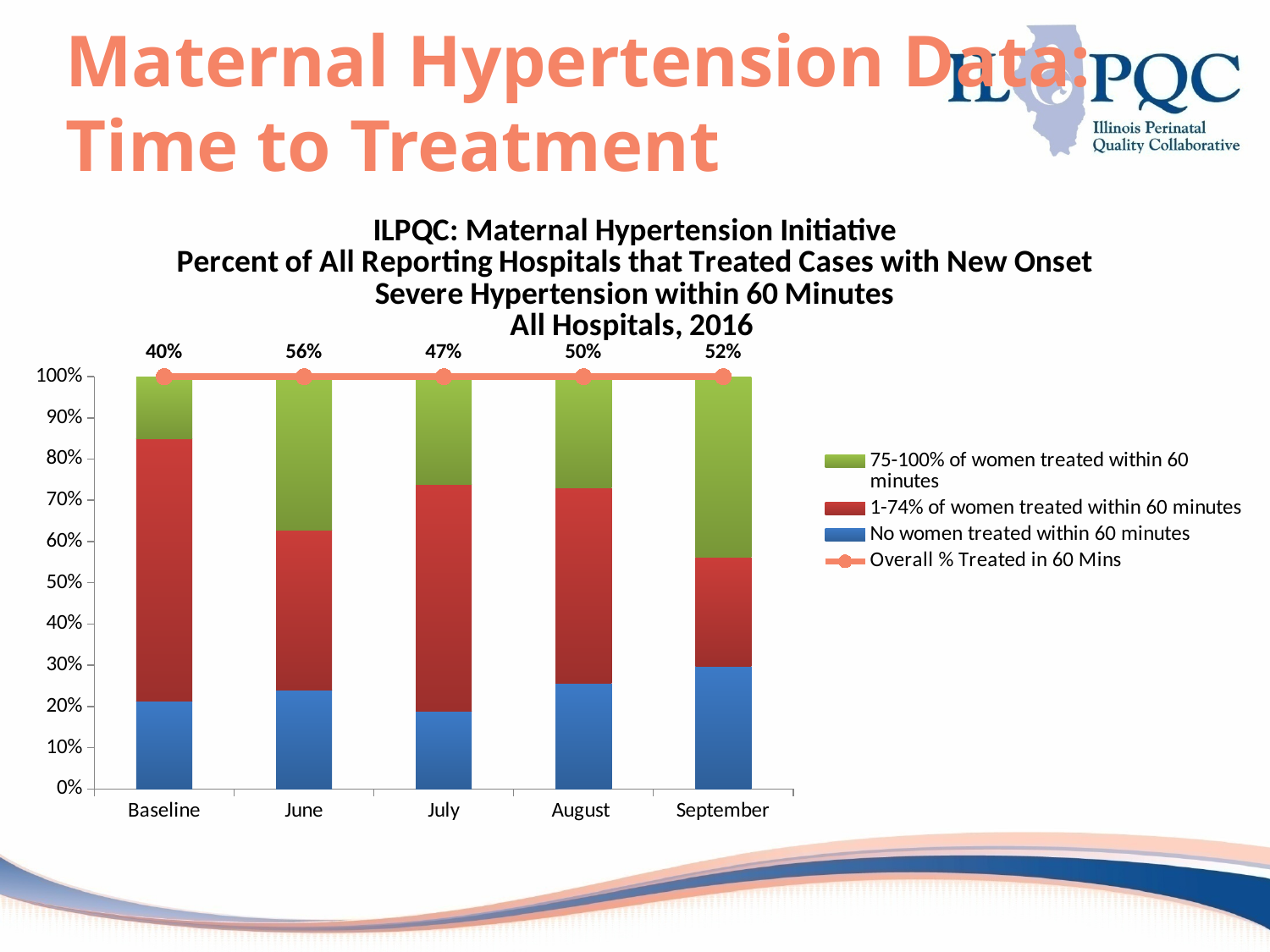
What is the difference between the Overall % Treated in 60 Mins for June and for Baseline? 16 percentage points Which category has the lowest Overall % Treated in 60 Mins? Baseline Does the Overall % Treated in 60 Mins rise or fall from Baseline to June? Rise Which has a higher Overall % Treated in 60 Mins, July or August? August What is the Overall % Treated in 60 Mins for September? 52% Which month has the highest Overall % Treated in 60 Mins? June Is the 'No women treated within 60 minutes' segment for Baseline greater or less than 30%? less What kind of chart is this? Stacked bar chart with a line How many categories are shown on the x axis? 5 Is the 'No women treated within 60 minutes' segment for September greater or less than 20%? greater What is the Overall % Treated in 60 Mins for Baseline? 40% How many series does the legend list? 4